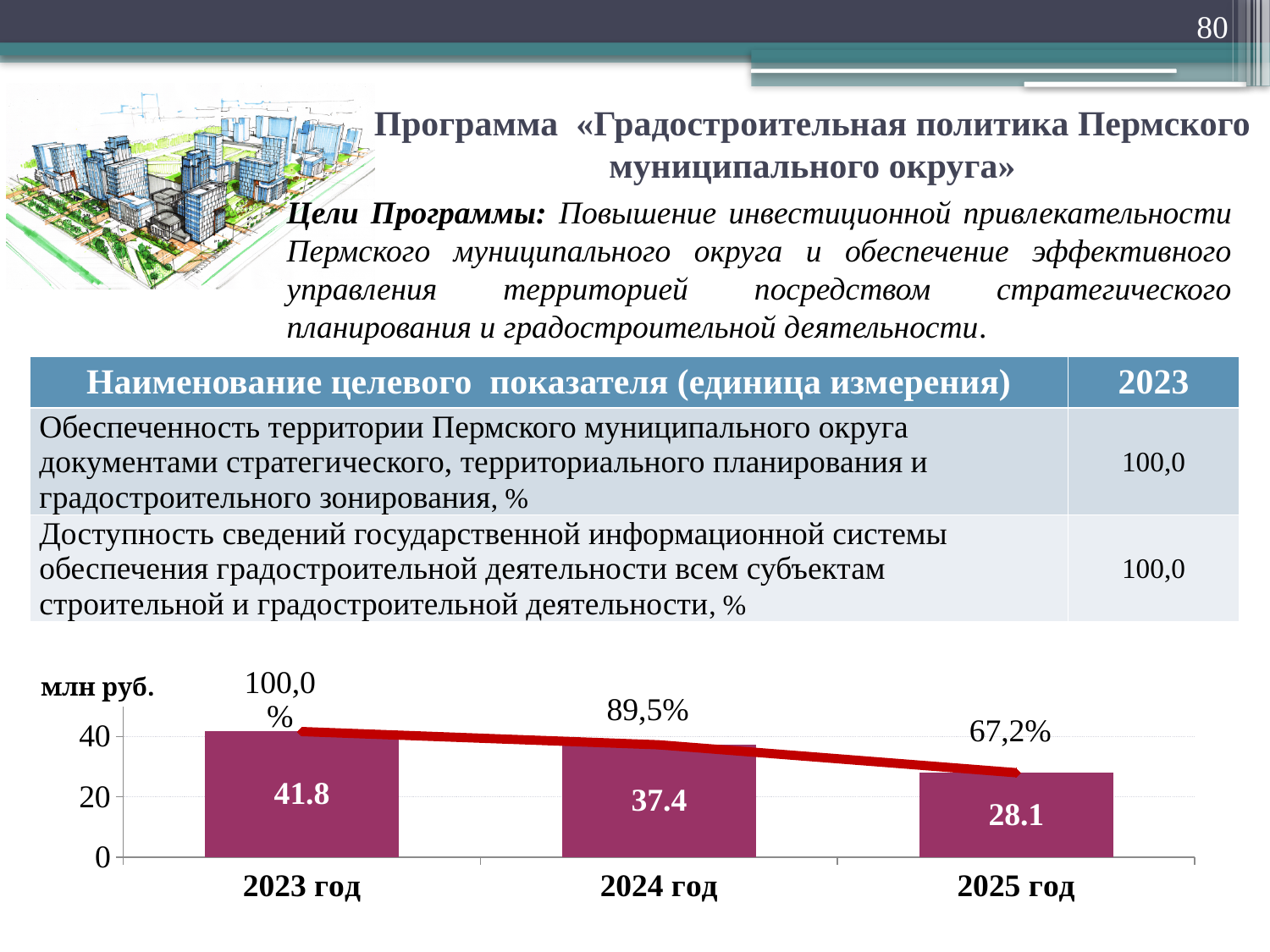
Is the value for 2025 год greater or less than 40? less What is the value for 2025 год in the bar chart? 28.1 Which year has the lowest value in the bar chart? 2025 год Which year has the highest value in the bar chart? 2023 год How many bars are shown in the chart? 3 What is the value for 2023 год in the bar chart? 41.8 Which is larger, the value for 2024 год or the value for 2025 год? 2024 год Do the values rise or fall from 2023 год to 2025 год? fall What is the difference between the values for 2023 год and 2024 год? 4.4 What is the value for 2024 год in the bar chart? 37.4 What is the difference between the values for 2023 год and 2025 год? 13.7 What kind of chart is shown on the slide? combination bar and line chart